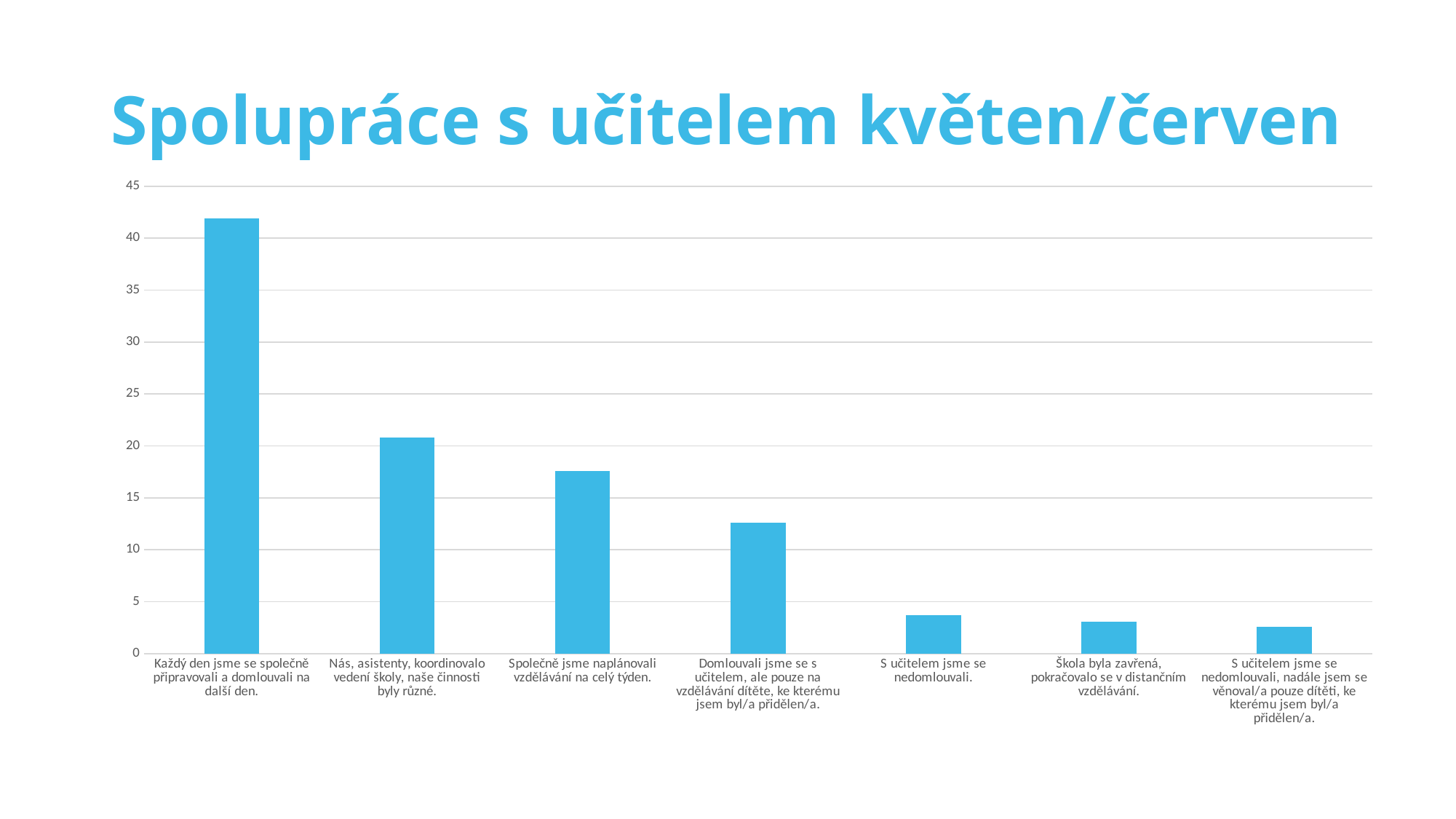
Is the value for "S učitelem jsme se nedomlouvali." greater or less than 5? less Which is larger: the value for "Nás, asistenty, koordinovalo vedení školy, naše činnosti byly různé." or the value for "Společně jsme naplánovali vzdělávání na celý týden."? Nás, asistenty, koordinovalo vedení školy, naše činnosti byly různé. Is the value for "Každý den jsme se společně připravovali a domlouvali na další den." greater or less than 40? greater Which category has the highest value? Každý den jsme se společně připravovali a domlouvali na další den. Is the value for "Nás, asistenty, koordinovalo vedení školy, naše činnosti byly různé." greater or less than 25? less What is the title of the chart? Spolupráce s učitelem květen/červen How many categories are shown on the x axis? 7 Do the values rise or fall from left to right along the x axis? fall What kind of chart is shown on the slide? bar chart What colour are the bars in the chart? blue